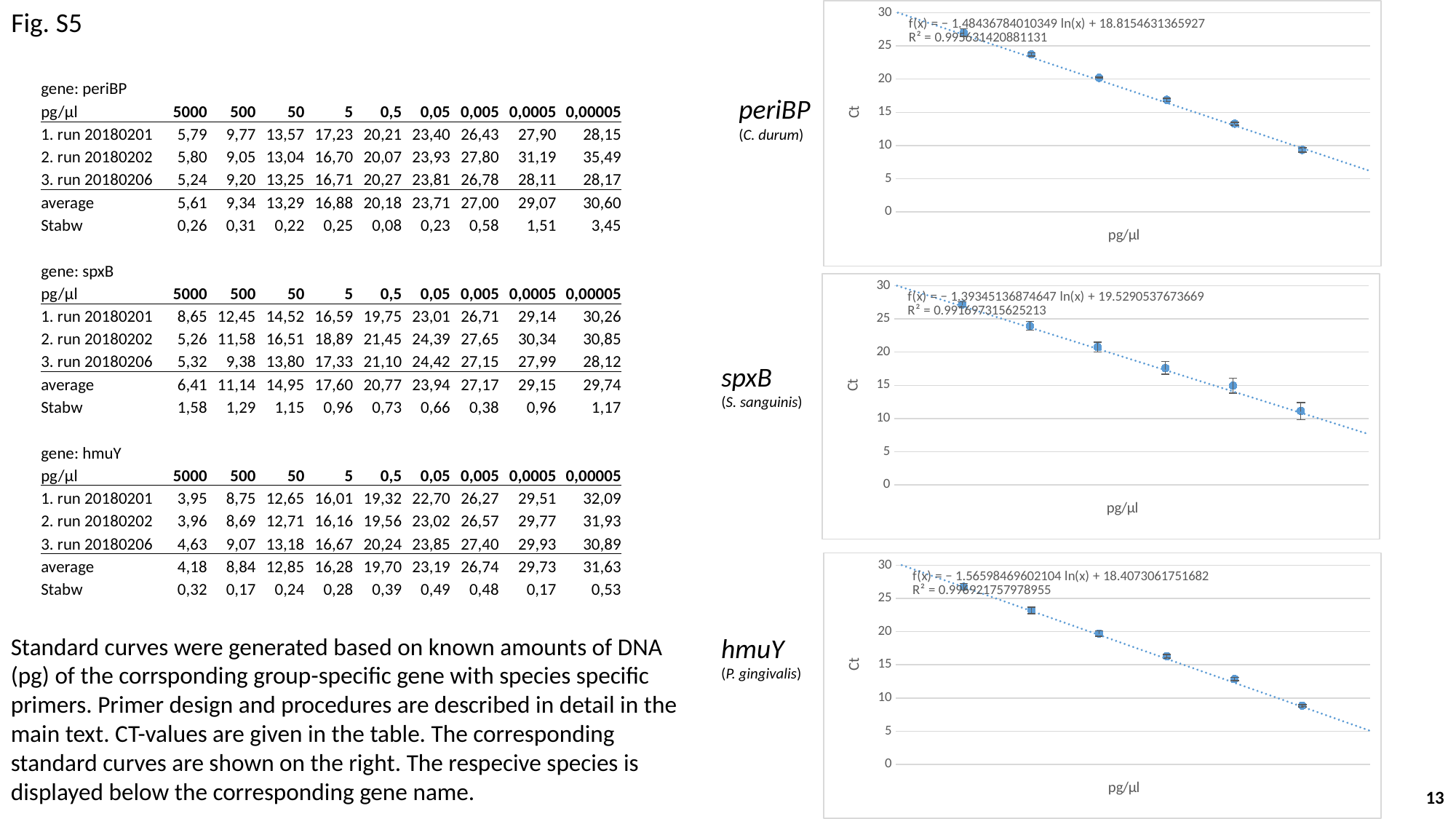
What is the x-axis label of the spxB chart? pg/µl In the periBP chart, is the Ct value of the leftmost point greater or less than 25? greater In the periBP chart, do the Ct values rise or fall from left to right along the x axis? fall In the hmuY chart, is the Ct value of the rightmost point greater or less than 10? less What is the y-axis label of the hmuY chart? Ct In the spxB chart, is the Ct value of the rightmost point greater or less than 15? less What kind of chart is the periBP chart? scatter chart In the spxB chart, do the Ct values rise or fall from left to right along the x axis? fall